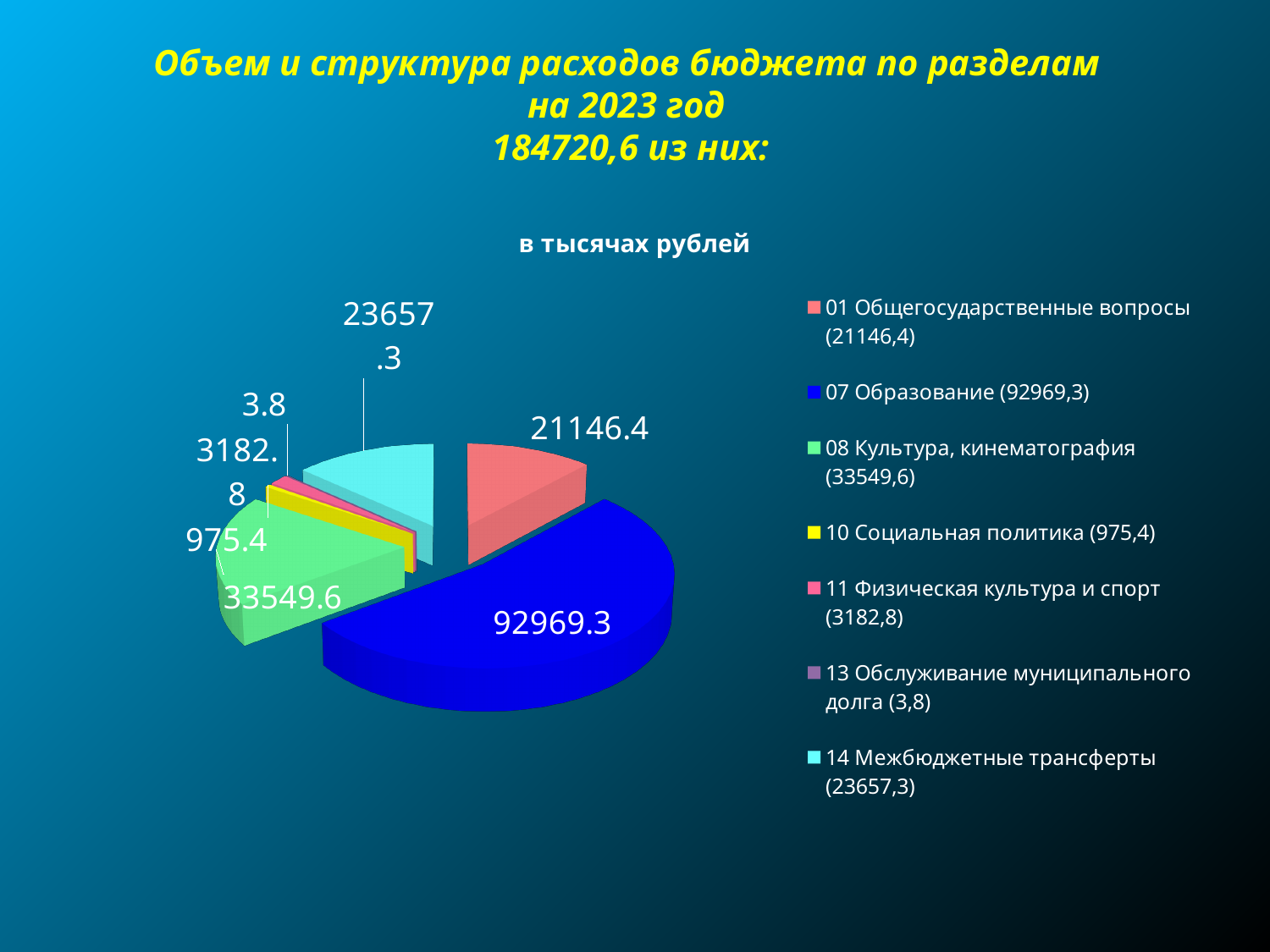
What is the value for 08 Культура, кинематография? 33549.6 What is the value for 14 Межбюджетные трансферты? 23657.3 Which category has the largest slice of the pie? 07 Образование What is the value for 07 Образование? 92969.3 What is the difference between the values for 14 Межбюджетные трансферты and 01 Общегосударственные вопросы? 2510.9 Which category has the smallest slice of the pie? 13 Обслуживание муниципального долга How many categories does the pie chart have? 7 What is the difference between the values for 07 Образование and 08 Культура, кинематография? 59419.7 What kind of chart is shown on the slide? pie chart What is the value for 10 Социальная политика? 975.4 Which is larger, the value for 11 Физическая культура и спорт or the value for 10 Социальная политика? 11 Физическая культура и спорт What is the title of the chart? в тысячах рублей